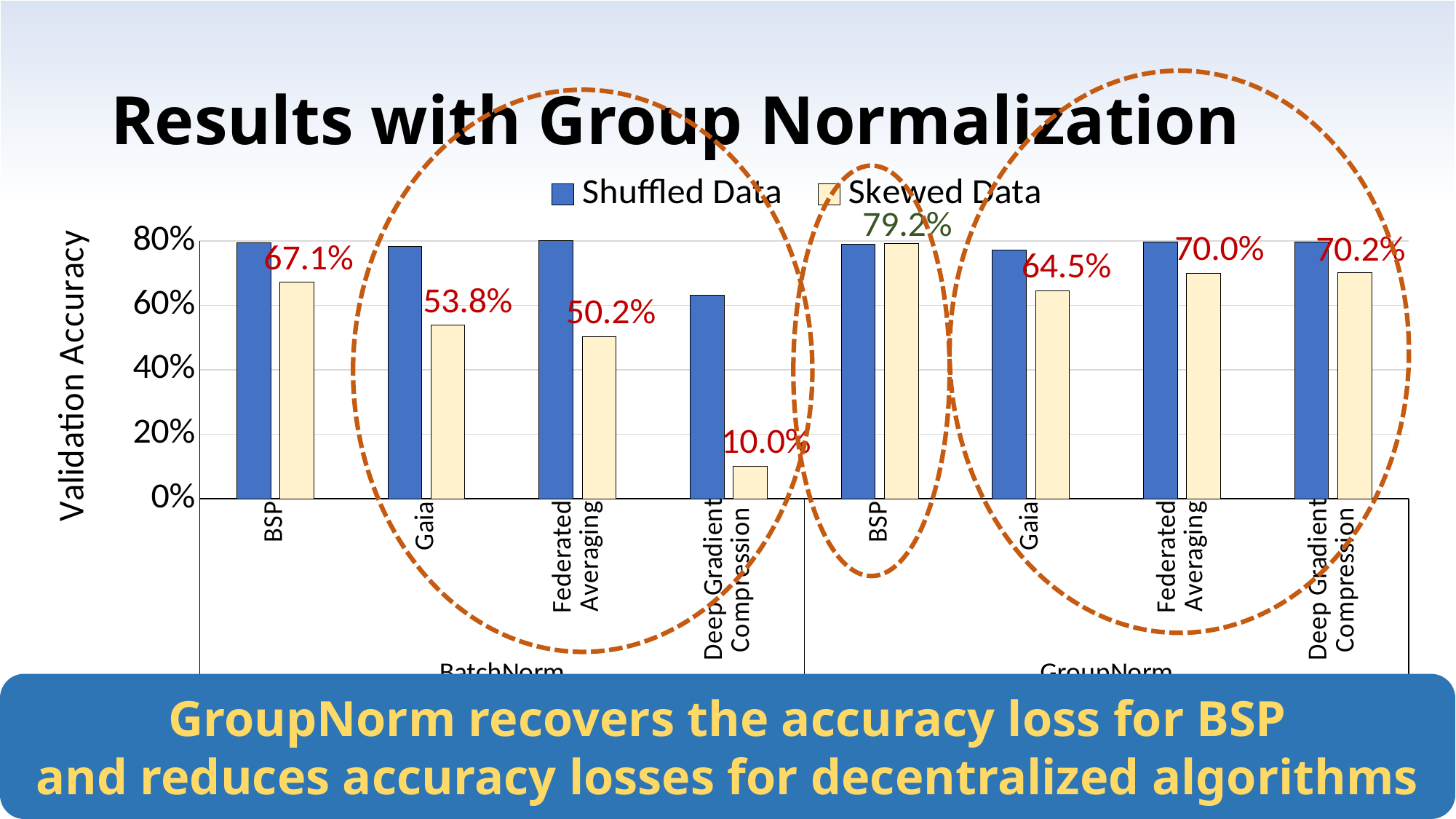
How much higher is the Skewed Data accuracy for BSP under GroupNorm than for BSP under BatchNorm? 12.1 percentage points What is the Skewed Data validation accuracy for Gaia under BatchNorm? 53.8% What is the Skewed Data validation accuracy for Federated Averaging under GroupNorm? 70.0% How many data series does the legend list? 2 What is the Skewed Data validation accuracy for BSP under GroupNorm? 79.2% What is the Skewed Data validation accuracy for Deep Gradient Compression under BatchNorm? 10.0% Which bar has the highest Skewed Data validation accuracy? BSP under GroupNorm Under GroupNorm, which has the higher Skewed Data accuracy: Gaia or Federated Averaging? Federated Averaging What kind of chart is shown on the slide? Bar chart Which bar has the lowest Skewed Data validation accuracy? Deep Gradient Compression under BatchNorm What is the difference in Skewed Data accuracy for Deep Gradient Compression between GroupNorm and BatchNorm? 60.2 percentage points Is the Shuffled Data value for Deep Gradient Compression under BatchNorm greater or less than 70%? less